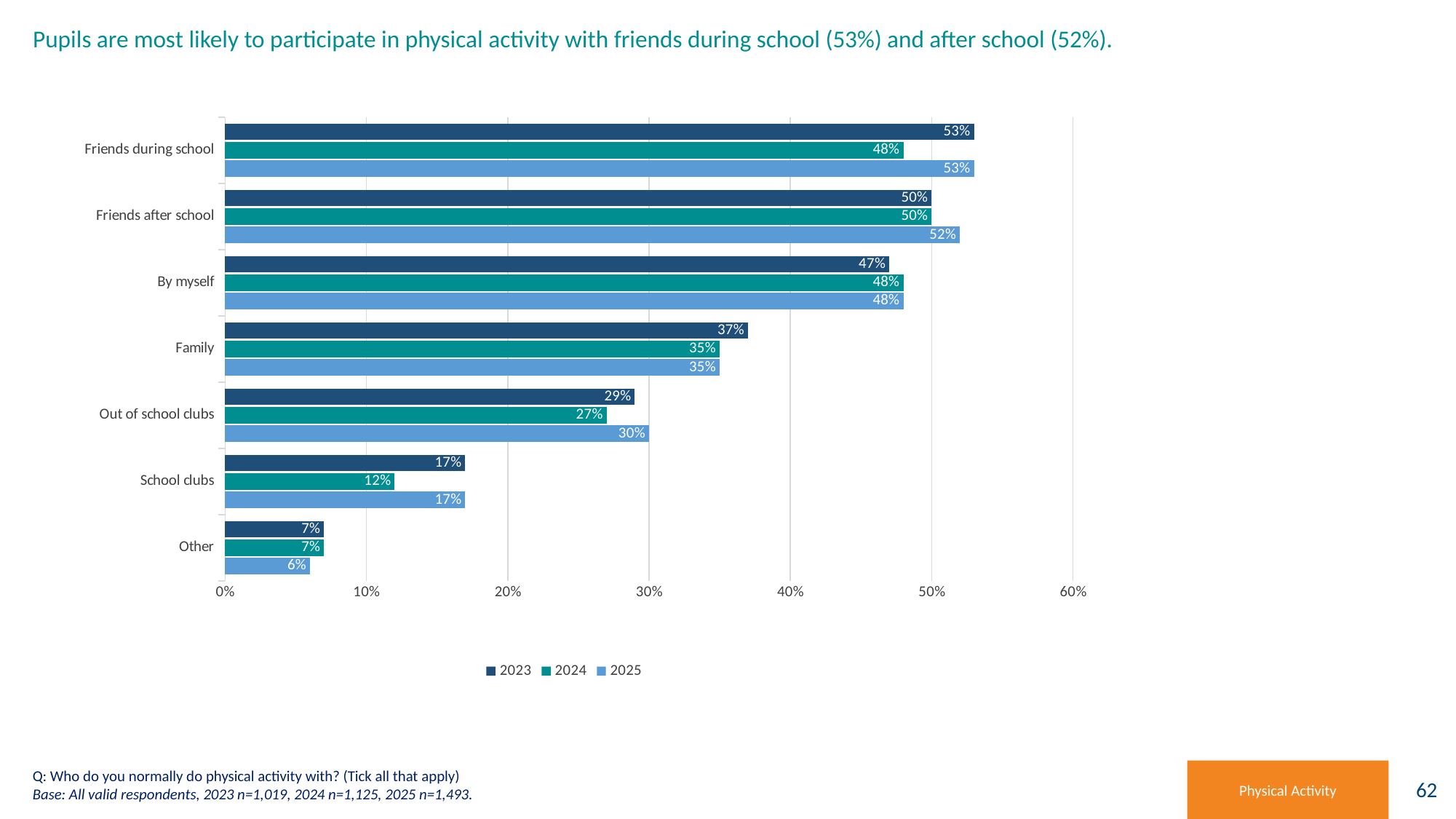
What is the 2025 value for Friends after school? 52% How many categories are shown on the chart? 7 What is the difference between the 2023 and 2025 values for Friends during school? 0% What is the 2023 value for Family? 37% Which is larger for Out of school clubs: the 2024 value or the 2025 value? 2025 Which category has the highest 2024 value? Friends after school Which category has the lowest 2025 value? Other Which series does the legend list first? 2023 What is the difference between the 2023 and 2024 values for School clubs? 5% What kind of chart is shown on the slide? Bar chart What is the 2024 value for School clubs? 12% How many series does the legend list? 3